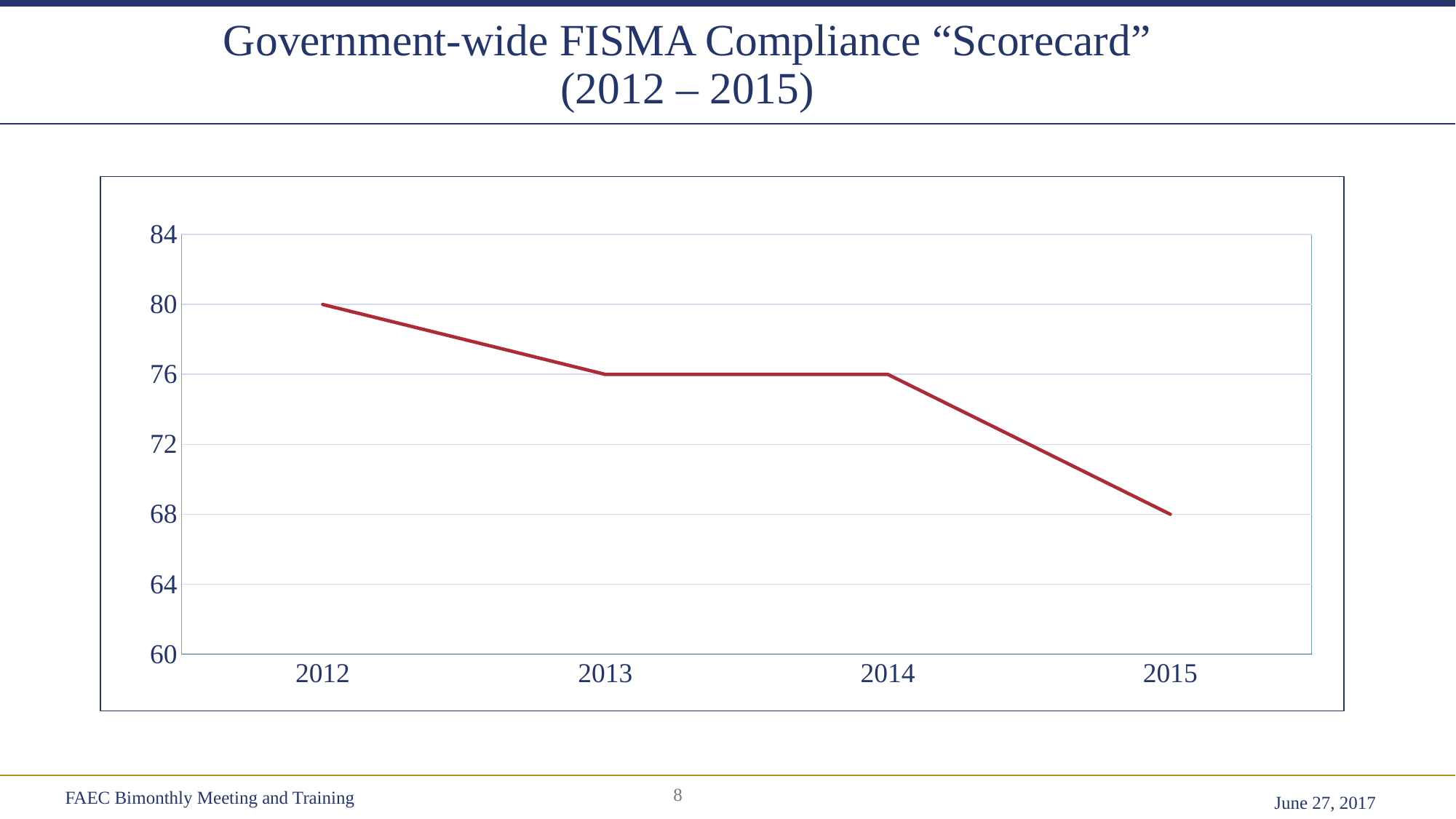
What is the value for 2012? 80 Is the value for 2015 greater or less than 72? less What is the difference between the values for 2014 and 2015? 8 Which year has the highest value? 2012 What is the difference between the values for 2012 and 2015? 12 Which is larger, the value for 2012 or the value for 2014? 2012 Do the values rise or fall from 2012 to 2015? fall What is the value for 2015? 68 How many years are plotted on the x axis? 4 What kind of chart is shown on the slide? line chart What is the value for 2013? 76 Which year has the lowest value? 2015